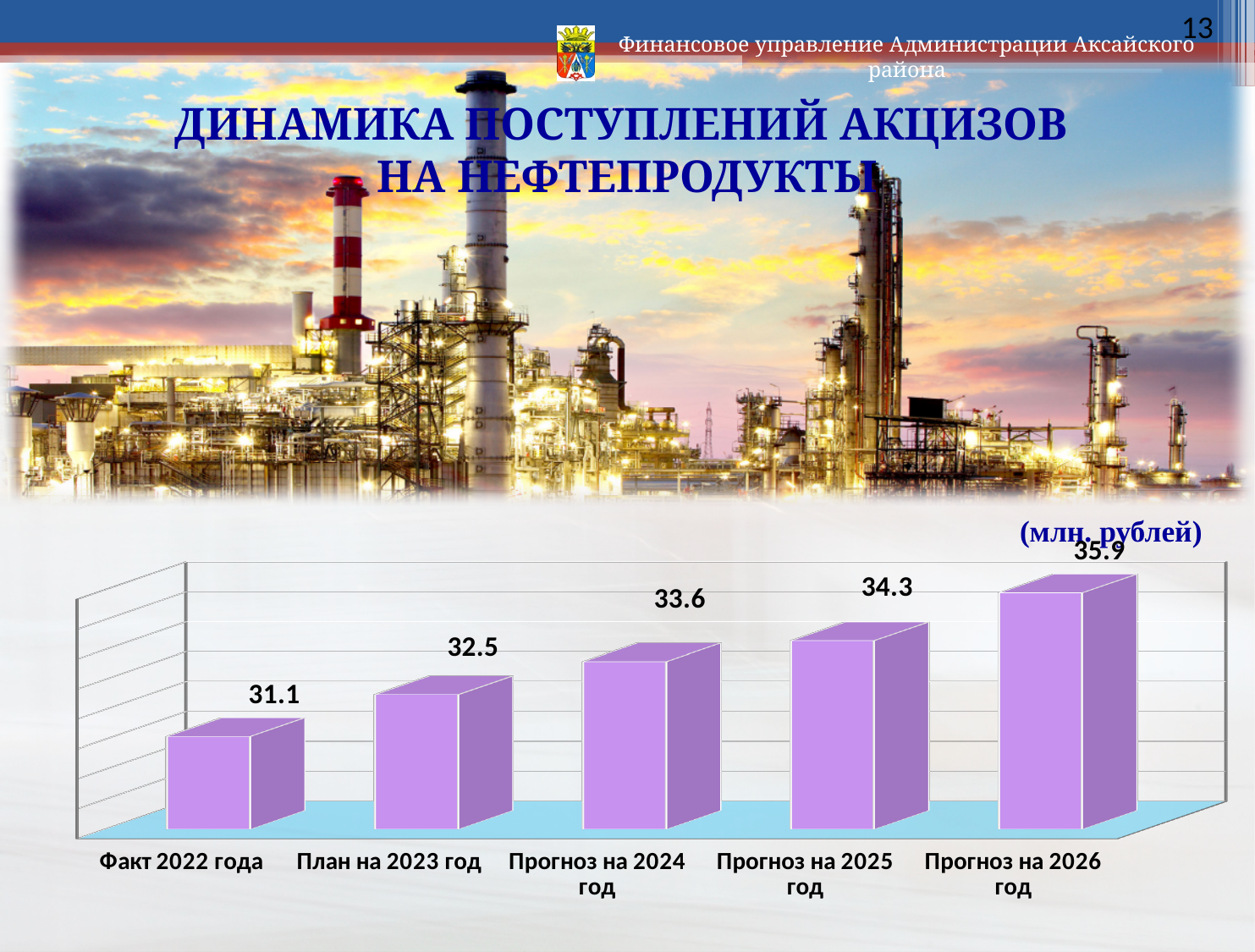
Do the values rise or fall from Факт 2022 года to Прогноз на 2026 год? Rise How many categories are shown in the chart? 5 What kind of chart is shown on the slide? Bar chart Which category has the lowest value? Факт 2022 года What is the value for Прогноз на 2026 год? 35.9 Which category has the highest value? Прогноз на 2026 год What is the value for Прогноз на 2024 год? 33.6 What unit is indicated for the chart values? млн. рублей Which is larger, the value for План на 2023 год or the value for Прогноз на 2024 год? Прогноз на 2024 год What is the value for Факт 2022 года? 31.1 What is the difference between the values for Прогноз на 2025 год and Факт 2022 года? 3.2 What is the value for План на 2023 год? 32.5